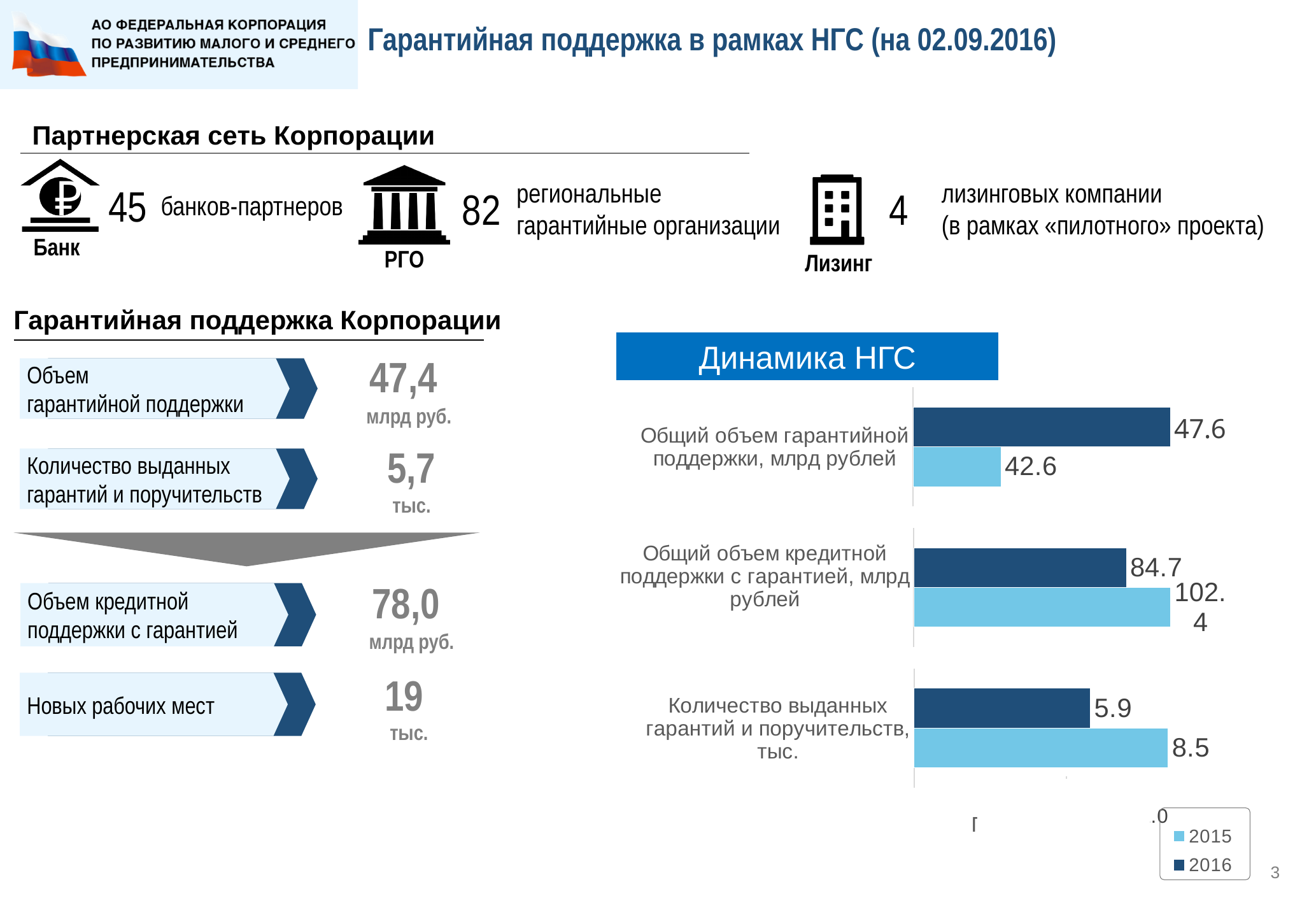
In the "Динамика НГС" chart, how many categories are shown? 3 In the "Динамика НГС" chart, what is the 2016 value for "Количество выданных гарантий и поручительств, тыс."? 5.9 In the "Динамика НГС" chart, what is the difference between the 2016 and 2015 values for "Общий объем гарантийной поддержки, млрд рублей"? 5.0 In the "Динамика НГС" chart, how many series does the legend list? 2 In the "Динамика НГС" chart, what is the 2015 value for "Общий объем кредитной поддержки с гарантией, млрд рублей"? 102.4 What type of chart is "Динамика НГС"? bar chart In the "Динамика НГС" chart, what is the 2016 value for "Общий объем кредитной поддержки с гарантией, млрд рублей"? 84.7 In the "Динамика НГС" chart, what is the 2015 value for "Количество выданных гарантий и поручительств, тыс."? 8.5 In the "Динамика НГС" chart, which year has the larger value for "Количество выданных гарантий и поручительств, тыс.", 2015 or 2016? 2015 In the "Динамика НГС" chart, which colour represents the 2016 series? dark blue In the "Динамика НГС" chart, what is the 2016 value for "Общий объем гарантийной поддержки, млрд рублей"? 47.6 In the "Динамика НГС" chart, what is the 2015 value for "Общий объем гарантийной поддержки, млрд рублей"? 42.6